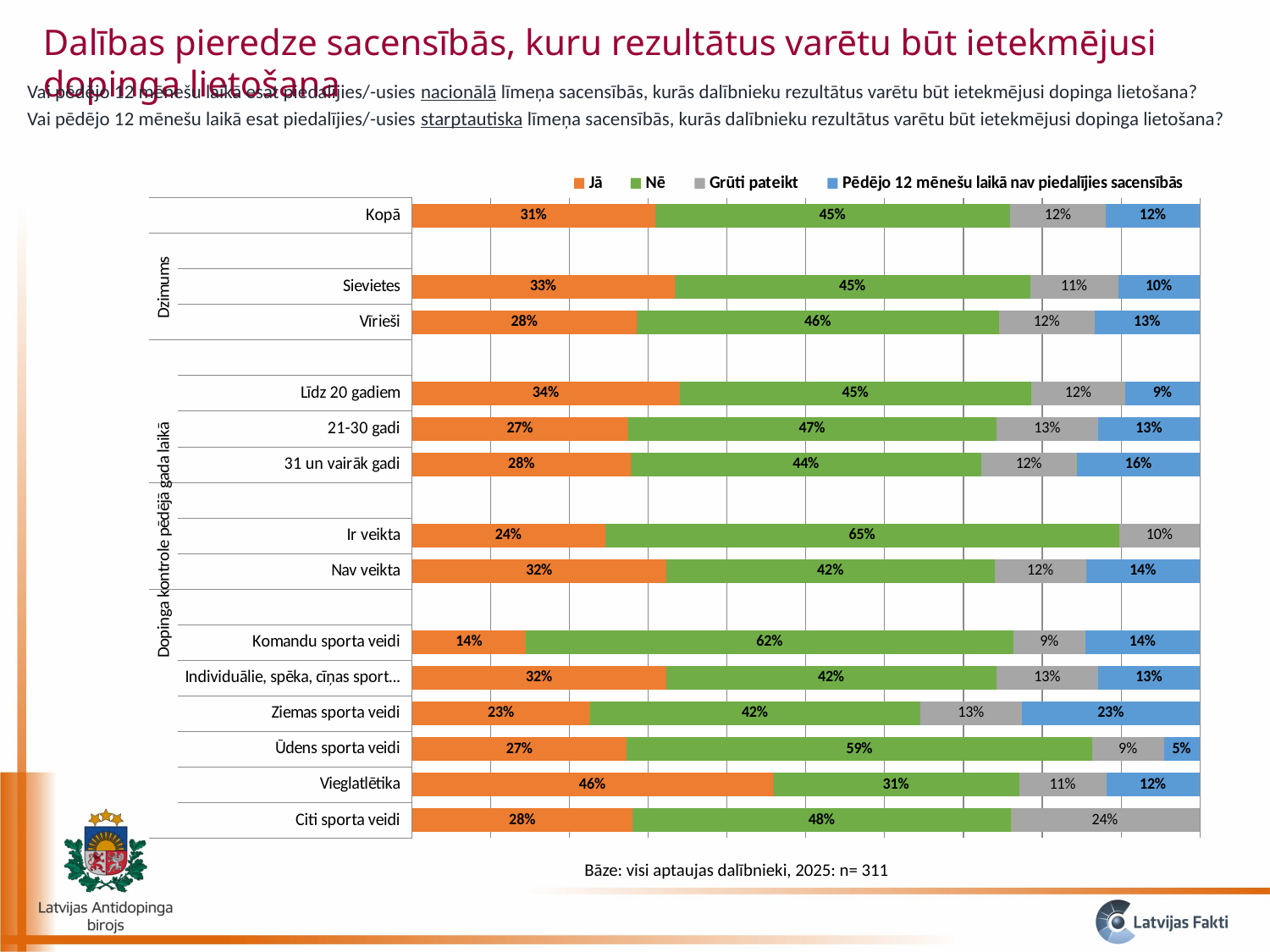
What is the "Jā" value for Kopā? 31% What is the difference between the "Nē" values for Komandu sporta veidi and Vieglatlētika? 31% What is the "Nē" value for Ir veikta? 65% What is the "Pēdējo 12 mēnešu laikā nav piedalījies sacensībās" value for Ziemas sporta veidi? 23% What kind of chart is shown on the slide? Stacked bar chart Which is larger, the "Jā" value for Sievietes or for Vīrieši? Sievietes Which category has the lowest "Jā" value? Komandu sporta veidi How many categories are shown on the chart? 14 How many series does the legend list? 4 What is the "Grūti pateikt" value for Citi sporta veidi? 24% Which category has the highest "Jā" value? Vieglatlētika What is the sample size stated below the chart? n= 311